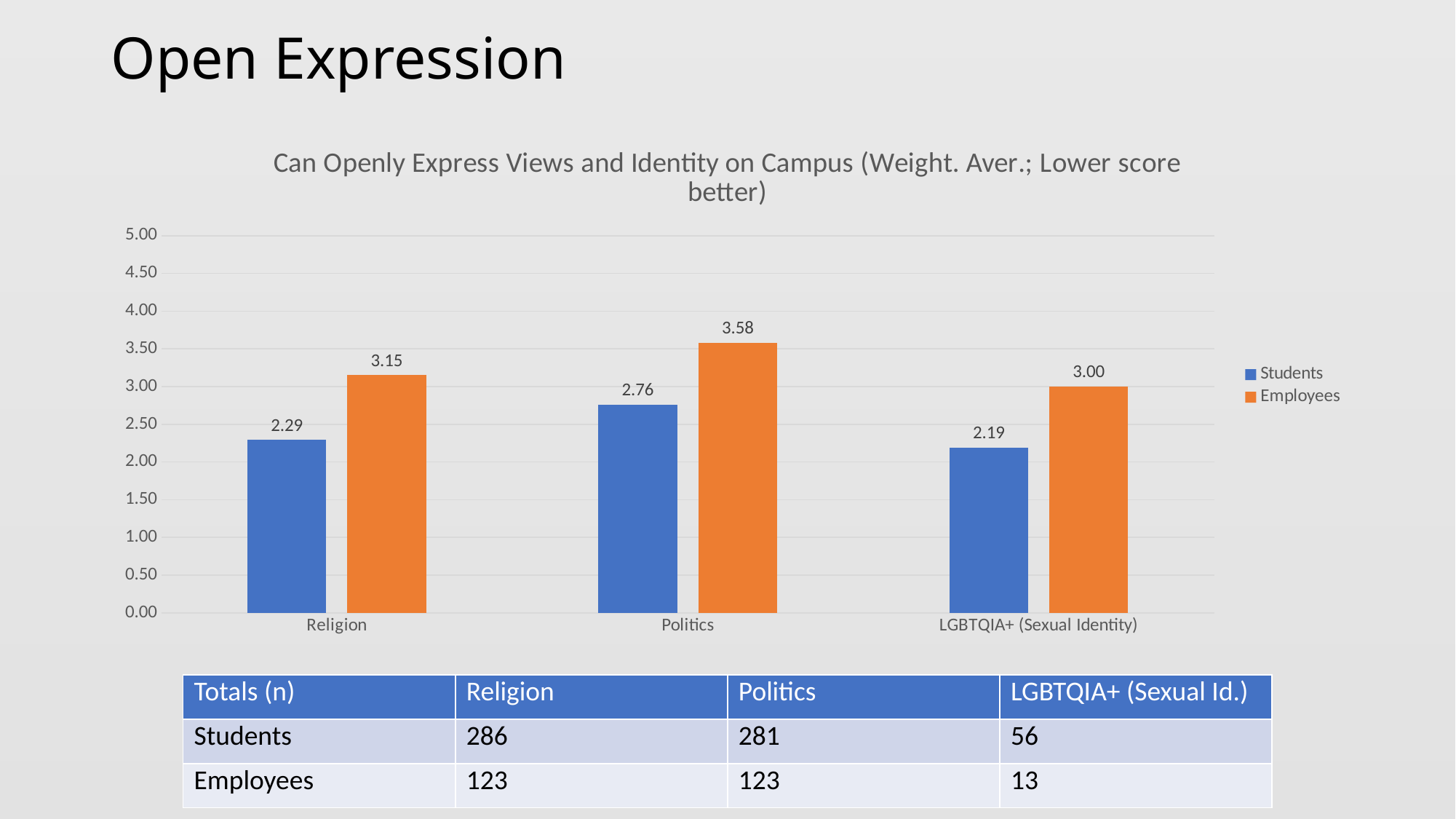
What is the Employees value for LGBTQIA+ (Sexual Identity)? 3.00 How many series does the legend list? 2 What kind of chart is shown? Bar chart What is the Employees value for Politics? 3.58 Is the Employees value for Religion greater or less than 3.00? greater How many categories are shown on the x axis? 3 What colour are the Employees bars? Orange What is the difference between the Employees and Students values for Politics? 0.82 What is the Students value for Religion? 2.29 Which category has the highest Students value? Politics Which category has the lowest Students value? LGBTQIA+ (Sexual Identity) Which is larger for Religion, the Students value or the Employees value? Employees